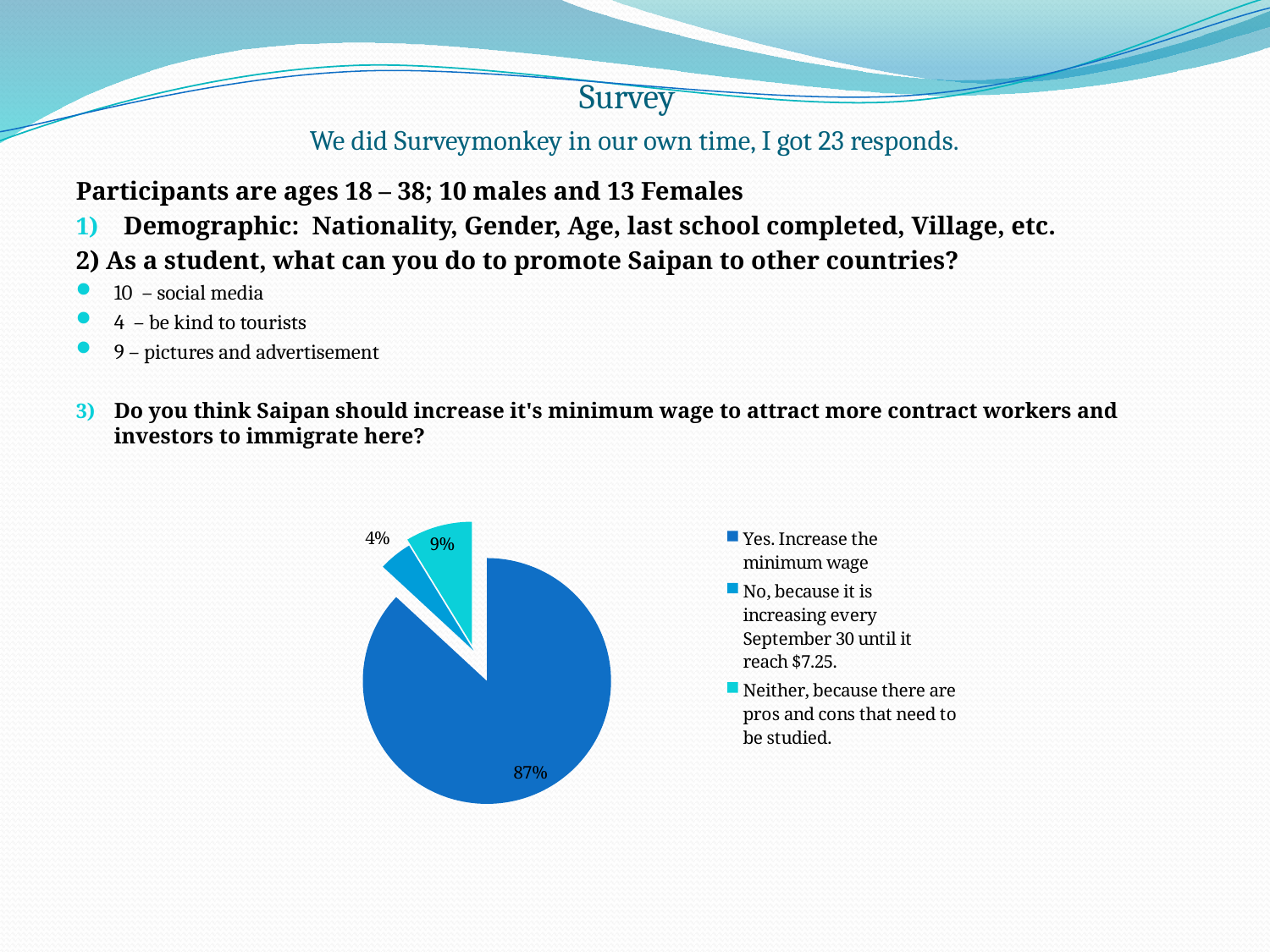
What type of chart is shown on the slide? pie chart How many slices does the pie chart have? 3 What colour is the slice for "Yes. Increase the minimum wage"? dark blue Which response has the smallest share of the pie? No, because it is increasing every September 30 until it reach $7.25. What is the combined share of the "No" and "Neither" slices? 13% How many entries does the legend list? 3 What percentage of respondents chose "Yes. Increase the minimum wage"? 87% What percentage of respondents chose "Neither, because there are pros and cons that need to be studied."? 9% What percentage of respondents chose "No, because it is increasing every September 30 until it reach $7.25."? 4% Which response has the largest share of the pie? Yes. Increase the minimum wage What is the difference in percentage points between the "Yes" slice and the "Neither" slice? 78 Which is larger, the "Neither" slice or the "No" slice? Neither